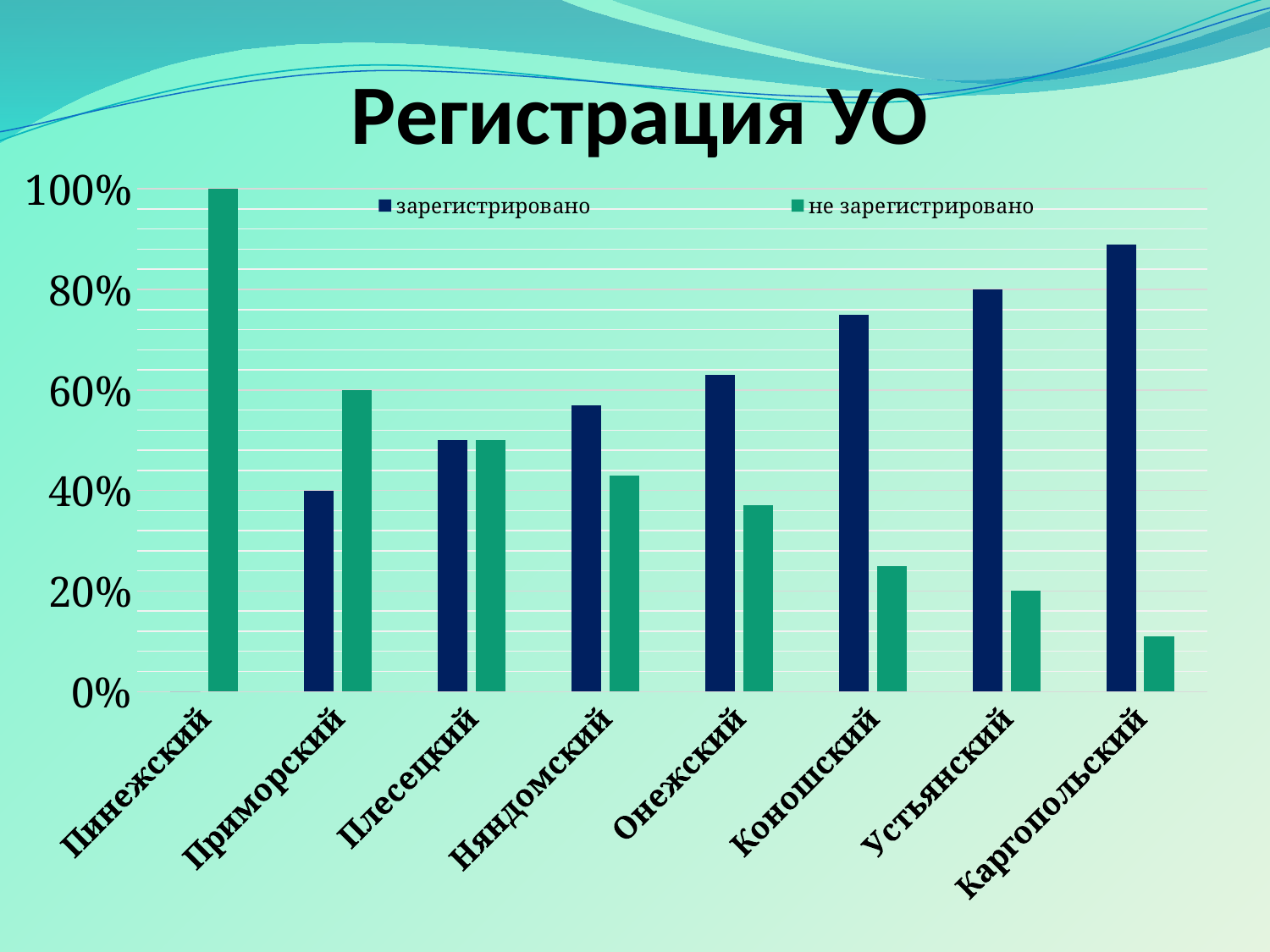
How many series does the legend list? 2 What is the title of the chart? Регистрация УО Does the 'зарегистрировано' series rise or fall from Приморский to Каргопольский along the x axis? rise How many districts (categories) are shown on the x axis? 8 Which district has the highest value for 'зарегистрировано'? Каргопольский What is the value of 'зарегистрировано' for Устьянский? 80% Which district has the lowest value for 'не зарегистрировано'? Каргопольский What kind of chart is shown on the slide? bar chart What is the value of 'не зарегистрировано' for Приморский? 60% For Онежский, which is larger: 'зарегистрировано' or 'не зарегистрировано'? зарегистрировано What is the value of 'не зарегистрировано' for Пинежский? 100% Is the value of 'зарегистрировано' for Коношский greater or less than 60%? greater